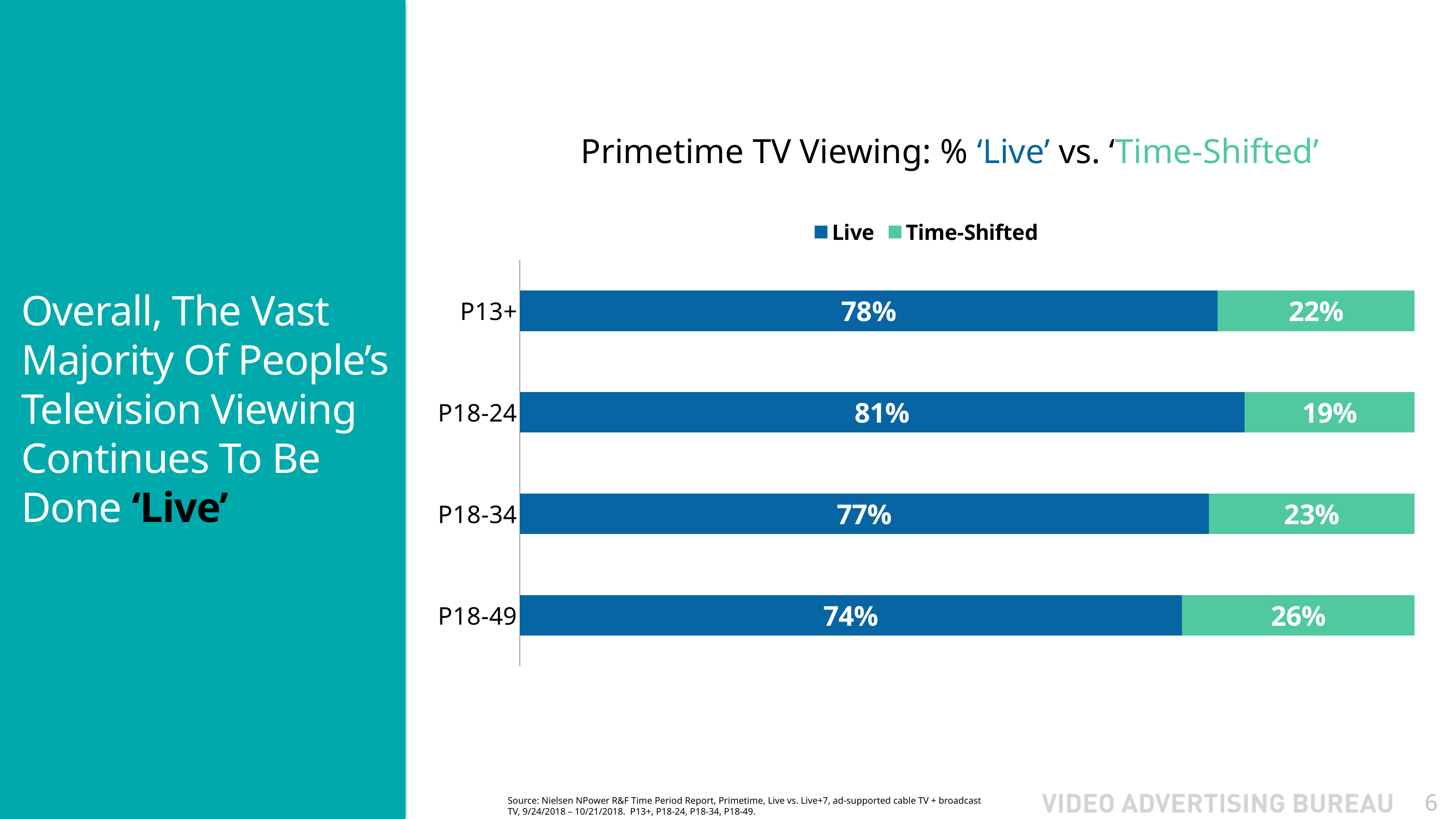
Which category has the highest Live value? P18-24 Which category has the lowest Live value? P18-49 Which category has the highest Time-Shifted value? P18-49 How many categories are shown on the chart? 4 What kind of chart is shown on the slide? Stacked bar chart What is the Time-Shifted value for P18-49? 26% What is the Live value for P18-24? 81% How many series does the legend list? 2 What is the title of the chart? Primetime TV Viewing: % 'Live' vs. 'Time-Shifted' What is the Live value for P13+? 78% What is the difference between the Live values for P18-24 and P18-49? 7% Which is larger, the Time-Shifted value for P18-34 or for P13+? P18-34